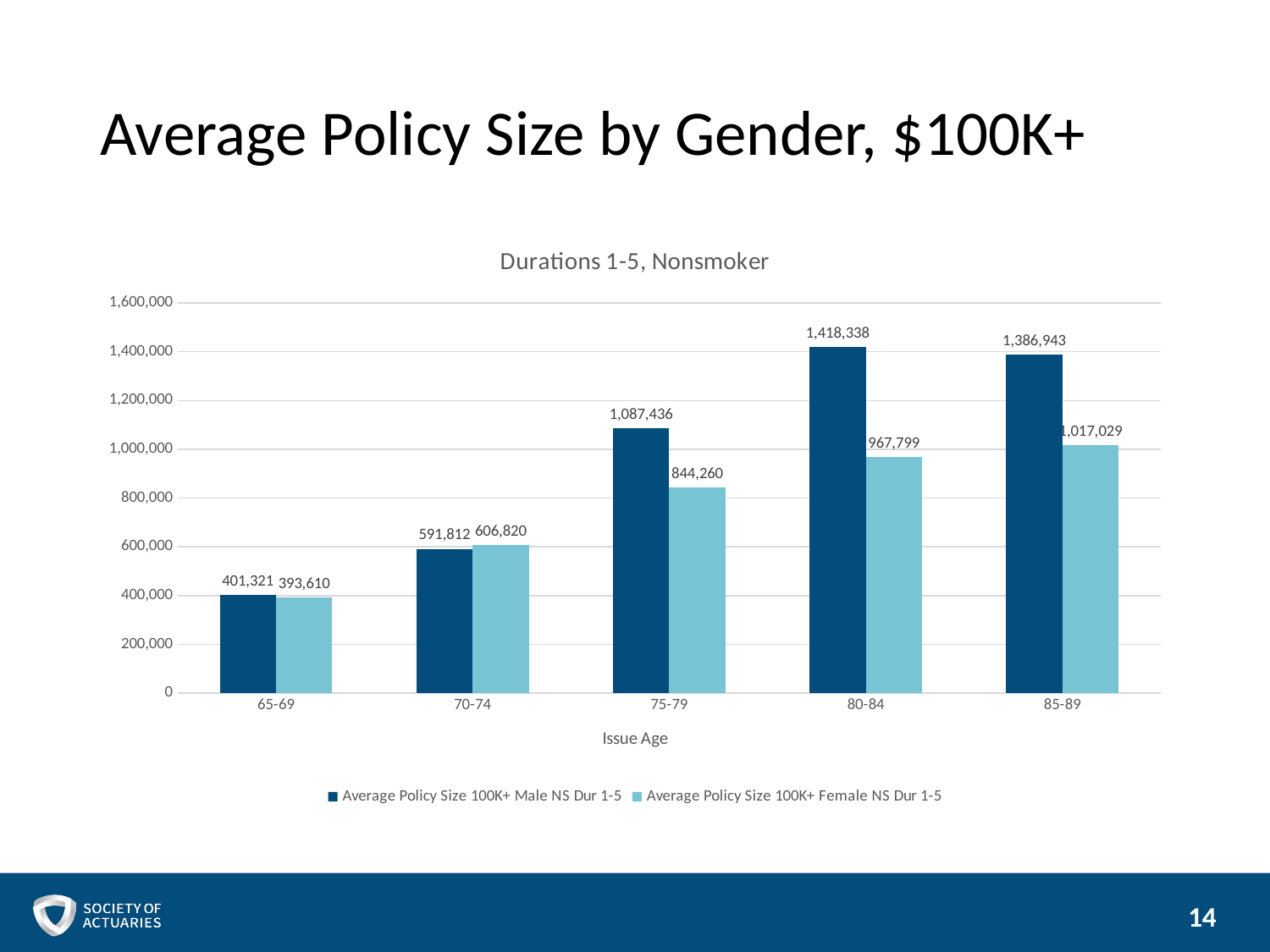
What is the difference between the male and female average policy size values for issue age 80-84? 450,539 What is the Average Policy Size 100K+ Male NS Dur 1-5 value for issue age 75-79? 1,087,436 Is the Average Policy Size 100K+ Female NS Dur 1-5 value for issue age 80-84 greater or less than 1,000,000? less What is the Average Policy Size 100K+ Female NS Dur 1-5 value for issue age 85-89? 1,017,029 How many series does the legend list? 2 What is the difference between the male and female average policy size values for issue age 75-79? 243,176 For issue age 70-74, which is larger: the male or the female average policy size? Female Which issue age group has the lowest Average Policy Size 100K+ Female NS Dur 1-5 value? 65-69 How many issue age groups are shown on the x axis? 5 What is the Average Policy Size 100K+ Female NS Dur 1-5 value for issue age 65-69? 393,610 What type of chart is shown on the slide? Bar chart Which issue age group has the highest Average Policy Size 100K+ Male NS Dur 1-5 value? 80-84